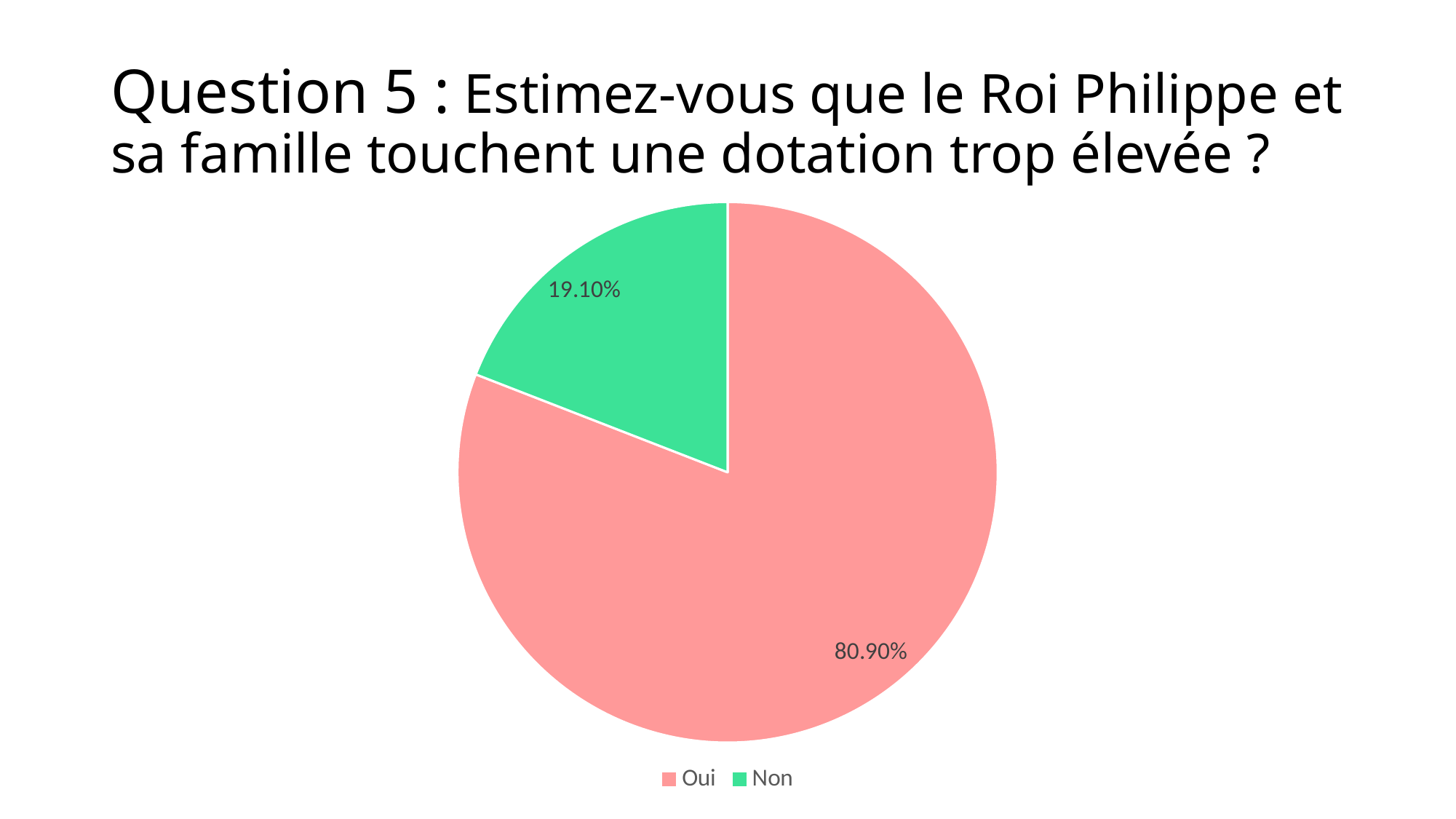
What share of the pie does the "Oui" slice represent? 80.90% How many entries does the legend list? 2 Which response has the smallest share of the pie? Non What percentage of respondents answered "Oui"? 80.90% Which response has the largest share of the pie? Oui What percentage of respondents answered "Non"? 19.10% What colour is the "Oui" slice? pink How many slices does the pie chart have? 2 What is the difference in percentage points between the "Oui" and "Non" slices? 61.80% What colour is the "Non" slice? green What kind of chart is shown on the slide? pie chart Which slice is larger, "Oui" or "Non"? Oui